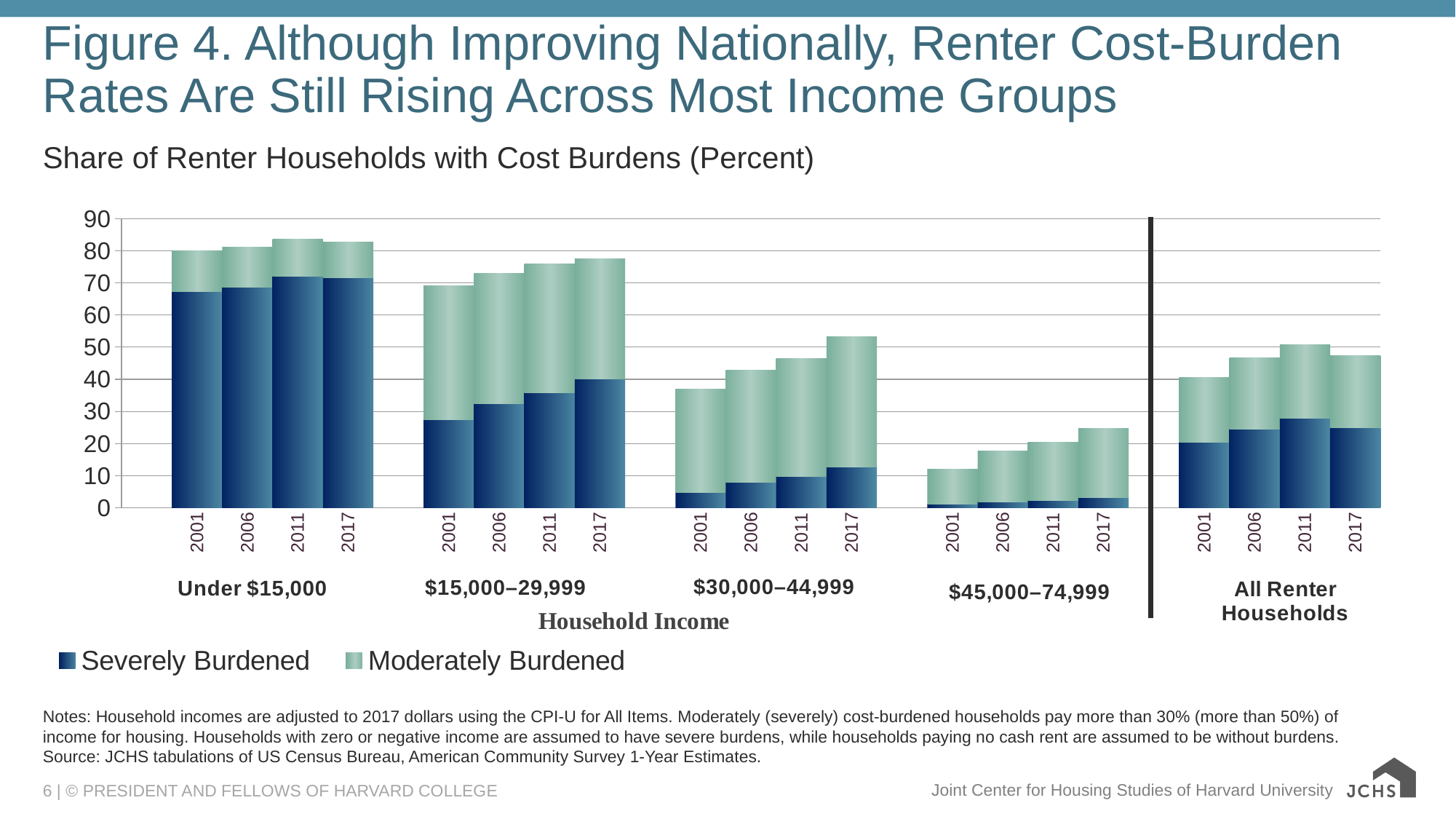
Does the total cost-burdened share for $15,000–29,999 rise or fall from 2001 to 2017? rises Is the total cost-burdened share for Under $15,000 in 2017 greater or less than 80? greater What are the two series named in the legend? Severely Burdened and Moderately Burdened Is the total cost-burdened share for $45,000–74,999 in 2001 greater or less than 20? less What kind of chart is shown on the slide? Stacked bar chart How many series does the legend list? 2 Which income group has the highest total cost-burdened share in 2017? Under $15,000 Which income group has the lowest total cost-burdened share in 2017? $45,000–74,999 How many household income groups are shown to the left of the vertical divider line? 4 How many years are plotted for each income group? 4 For All Renter Households, is the total cost-burdened share larger in 2001 or in 2011? 2011 Is the Severely Burdened share for Under $15,000 in 2011 greater or less than 60? greater